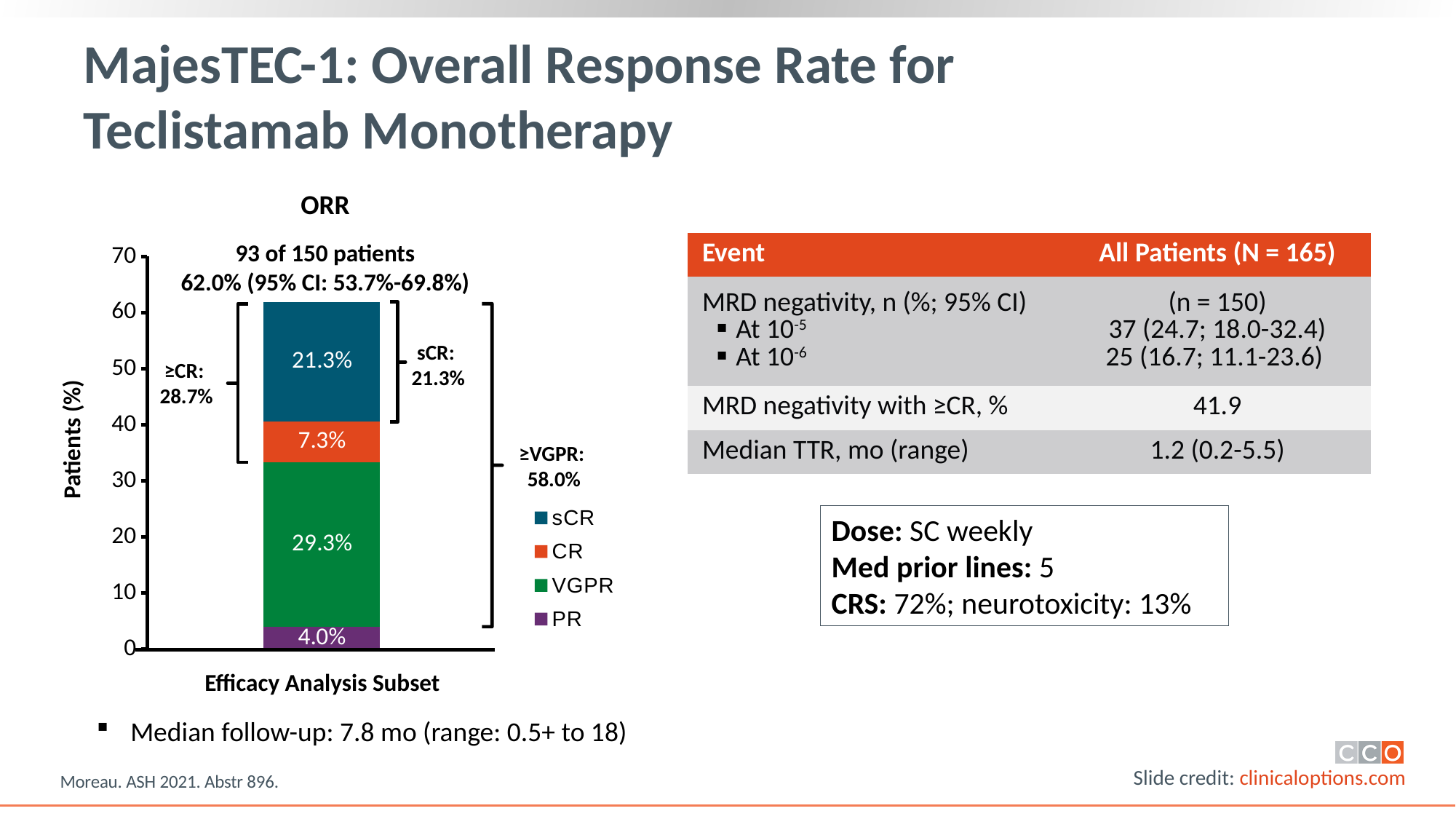
What is the total height of the stacked bar (the overall response rate)? 62.0% What is the value of the PR segment in the ORR chart? 4.0% What is the value of the sCR segment in the ORR chart? 21.3% What is the difference between the VGPR and sCR segment values? 8.0% What is the value of the CR segment in the ORR chart? 7.3% How many series does the chart legend list? 4 Which is larger, the sCR segment or the CR segment? sCR What is the label on the y-axis of the chart? Patients (%) Which response category has the smallest segment in the stacked bar? PR Which response category has the largest segment in the stacked bar? VGPR What is the value of the VGPR segment in the ORR chart? 29.3% What type of chart is shown on the slide? Stacked bar chart